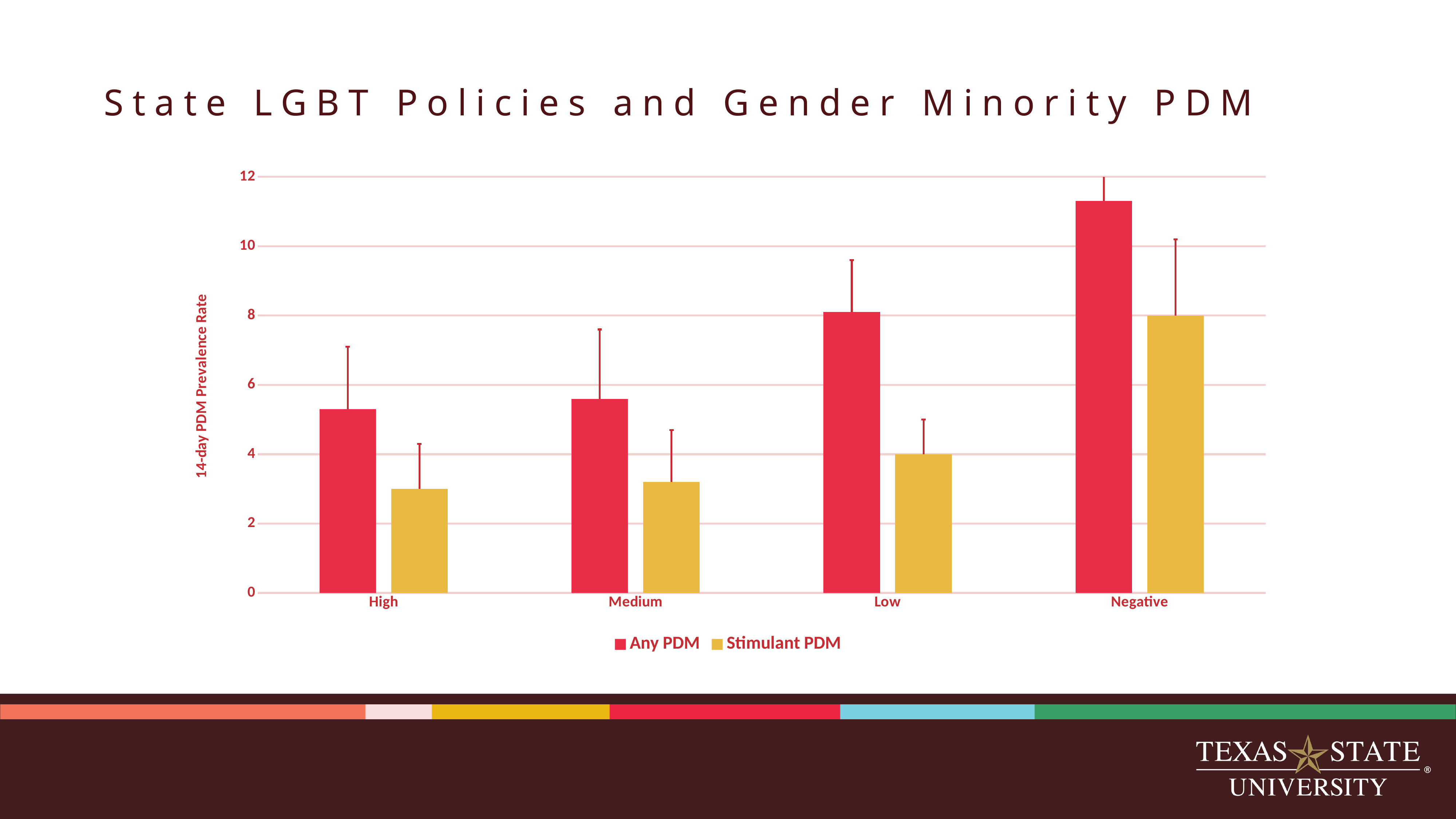
What kind of chart is shown on the slide? bar chart Which category has the highest Any PDM value? Negative Which category has the highest Stimulant PDM value? Negative How many series does the legend list? 2 Do the Any PDM values rise or fall moving from High to Negative along the x axis? rise Is the Any PDM value for High greater or less than 6? less What is the label of the y axis? 14-day PDM Prevalence Rate Is the Stimulant PDM value for Medium greater or less than 4? less For the Low category, which is larger: Any PDM or Stimulant PDM? Any PDM How many state policy categories are shown on the x axis? 4 Is the Any PDM value for Low greater or less than 10? less